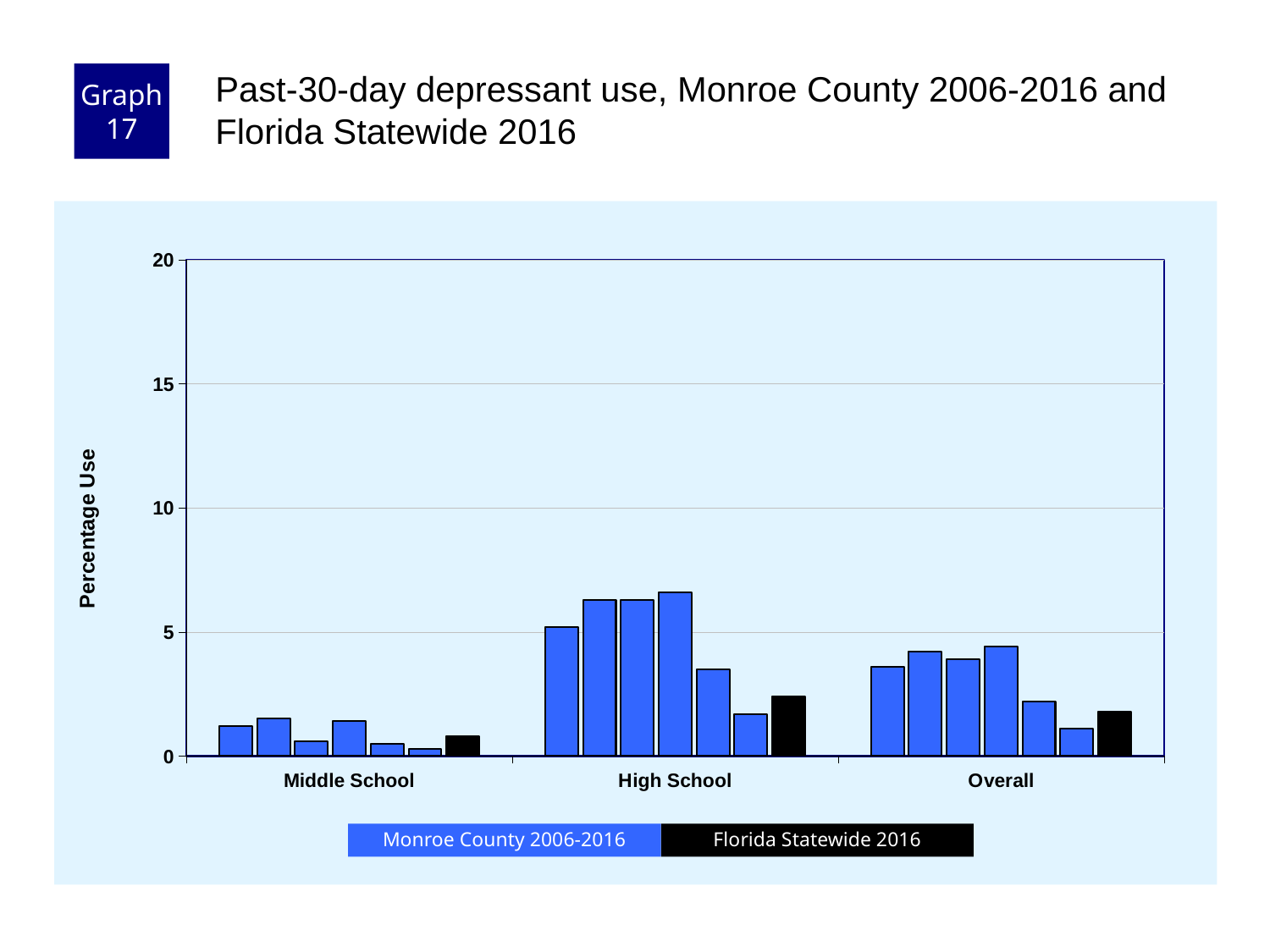
Is the Florida Statewide 2016 value for High School greater or less than 5? less Is the Florida Statewide 2016 bar for Overall larger or smaller than the Florida Statewide 2016 bar for High School? smaller What kind of chart is shown on the slide? bar chart Which category has the shortest bars overall? Middle School Is the Florida Statewide 2016 bar for High School larger or smaller than the Florida Statewide 2016 bar for Middle School? larger How many series does the legend list? 2 Which category has the tallest bars overall: Middle School, High School, or Overall? High School How many categories are shown on the x axis? 3 Are all the Monroe County 2006-2016 bars for High School greater or less than 10? less Which colour represents Florida Statewide 2016 in the legend? black What is the label of the y axis? Percentage Use Is the Florida Statewide 2016 value for Middle School greater or less than 5? less